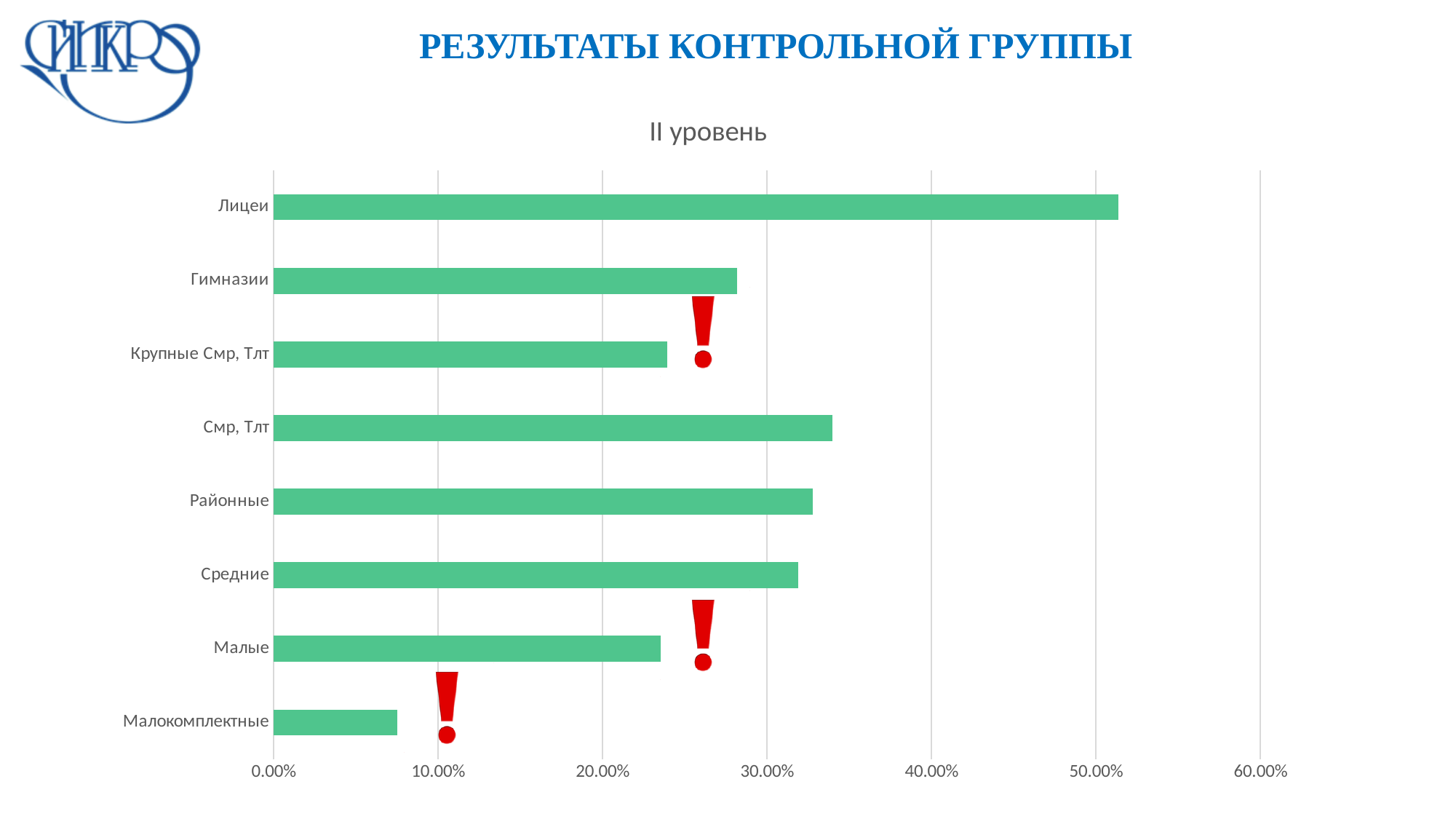
What kind of chart is shown on the slide? bar chart Is the value for Малые greater or less than 20.00%? greater Is the value for Смр, Тлт greater or less than 30.00%? greater Is the value for Малокомплектные greater or less than 10.00%? less Which is larger, the value for Лицеи or the value for Гимназии? Лицеи What is the title of the chart? II уровень How many categories are plotted in the chart? 8 Which is larger, the value for Смр, Тлт or the value for Крупные Смр, Тлт? Смр, Тлт Which category has the lowest value? Малокомплектные Which category has the highest value? Лицеи